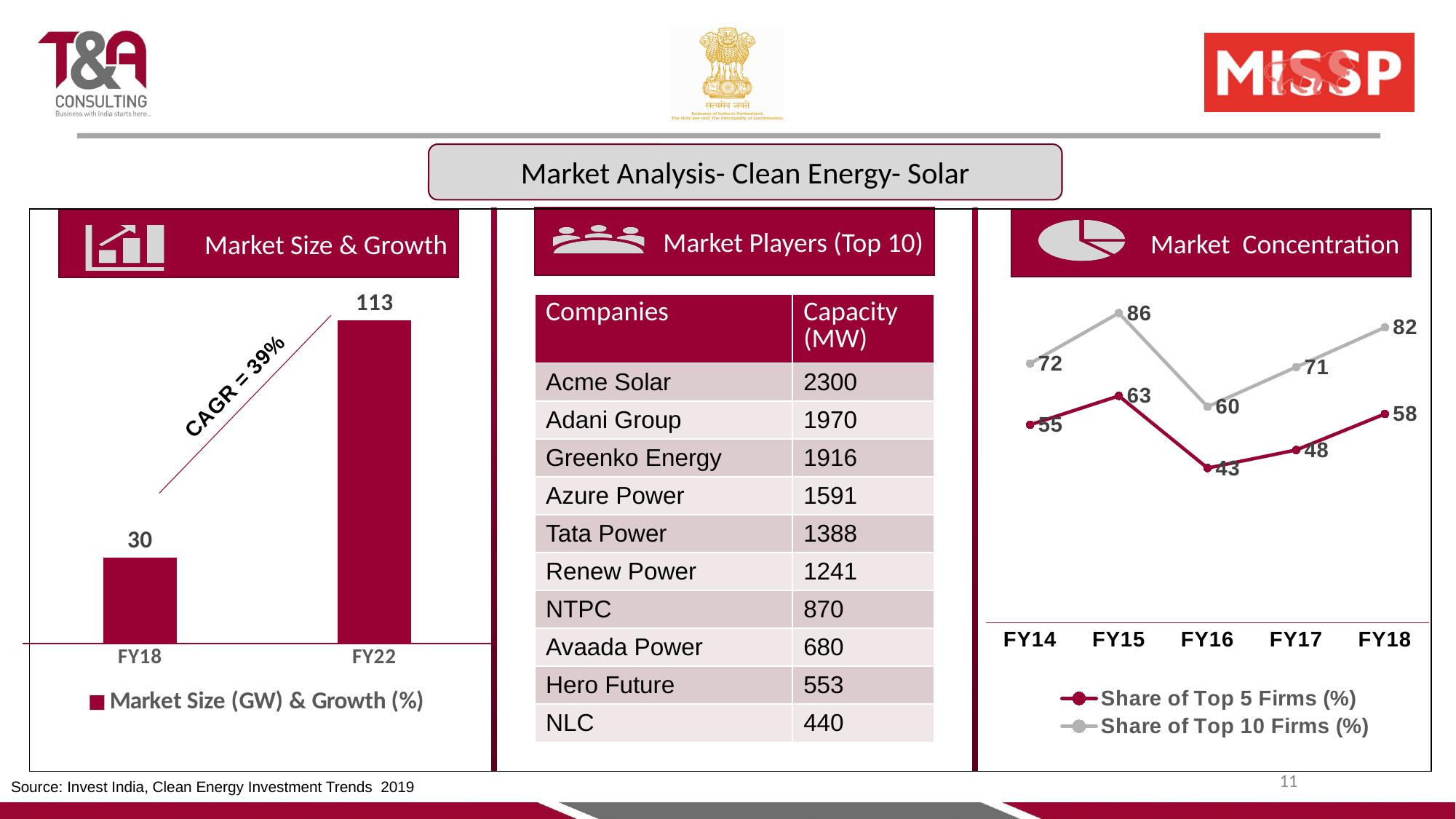
In the Market Size & Growth chart, what CAGR is annotated on the chart? CAGR = 39% In the Market Concentration chart, what is the difference between the Share of Top 10 Firms and the Share of Top 5 Firms in FY18? 24 How many series does the legend of the Market Concentration chart list? 2 In the Market Size & Growth chart, what is the difference between the FY22 and FY18 values? 83 What kind of chart is the Market Size & Growth chart? Bar chart In the Market Concentration chart, what is the Share of Top 5 Firms (%) in FY16? 43 In the Market Size & Growth chart, what is the value for FY22? 113 How many fiscal years are plotted on the x axis of the Market Concentration chart? 5 In the Market Concentration chart, what is the Share of Top 10 Firms (%) in FY15? 86 In the Market Size & Growth chart, what is the value for FY18? 30 In the Market Concentration chart, in which fiscal year is the Share of Top 10 Firms (%) highest? FY15 In the Market Concentration chart, in which fiscal year is the Share of Top 5 Firms (%) lowest? FY16